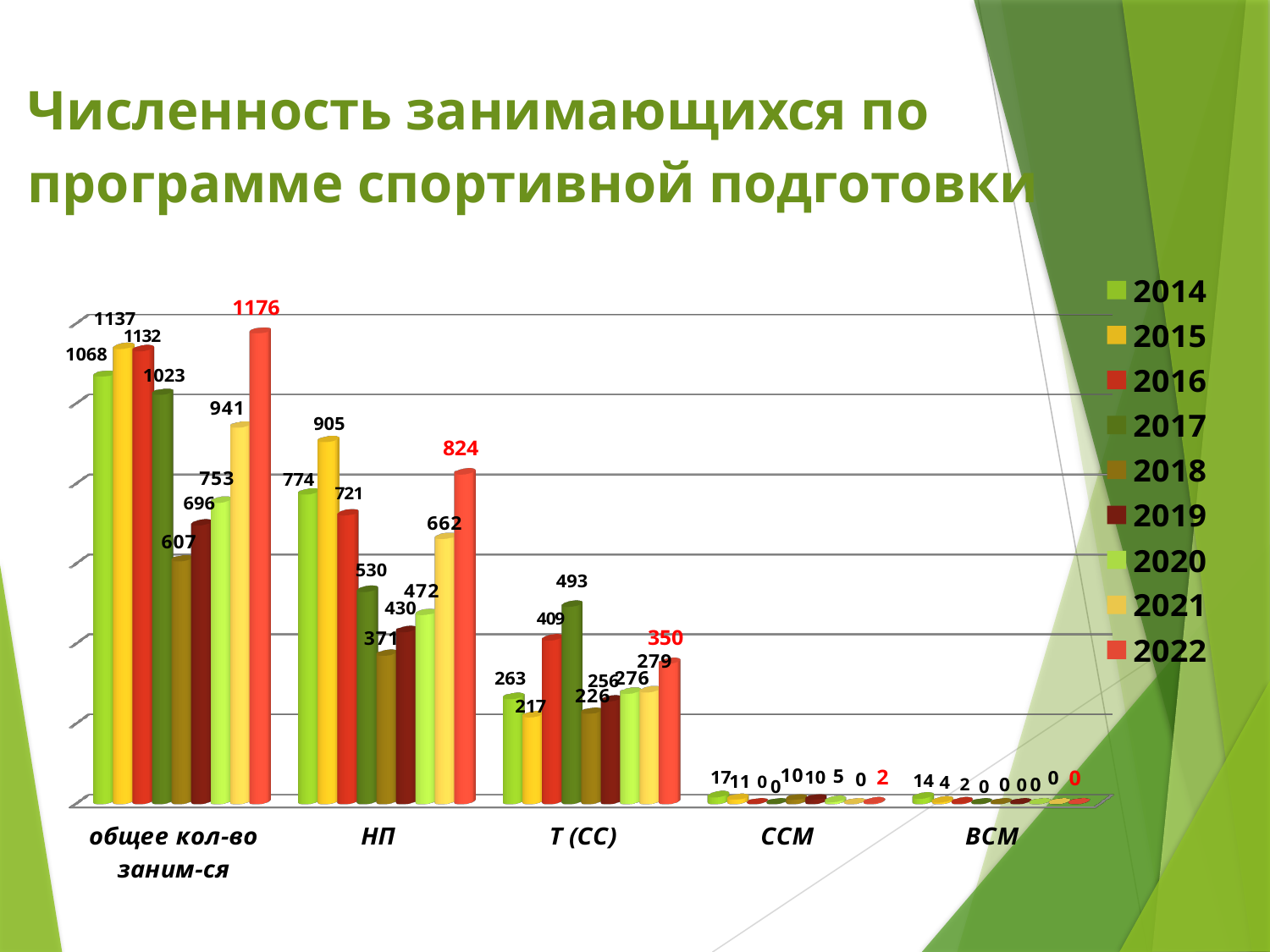
Which year has the lowest value in the 'НП' category? 2018 How many series does the legend list? 9 What is the value for 2014 in the 'ССМ' category? 17 What is the value for 2017 in the 'Т (СС)' category? 493 What is the value for 2022 in the 'общее кол-во заним-ся' category? 1176 What kind of chart is shown on the slide? bar chart Which is larger in the 'Т (СС)' category: the value for 2016 or the value for 2022? 2016 Which year has the highest value in the 'общее кол-во заним-ся' category? 2022 What is the value for 2015 in the 'НП' category? 905 What is the difference between the 2022 and 2018 values in the 'общее кол-во заним-ся' category? 569 What is the title of the slide? Численность занимающихся по программе спортивной подготовки How many categories are shown on the x axis? 5